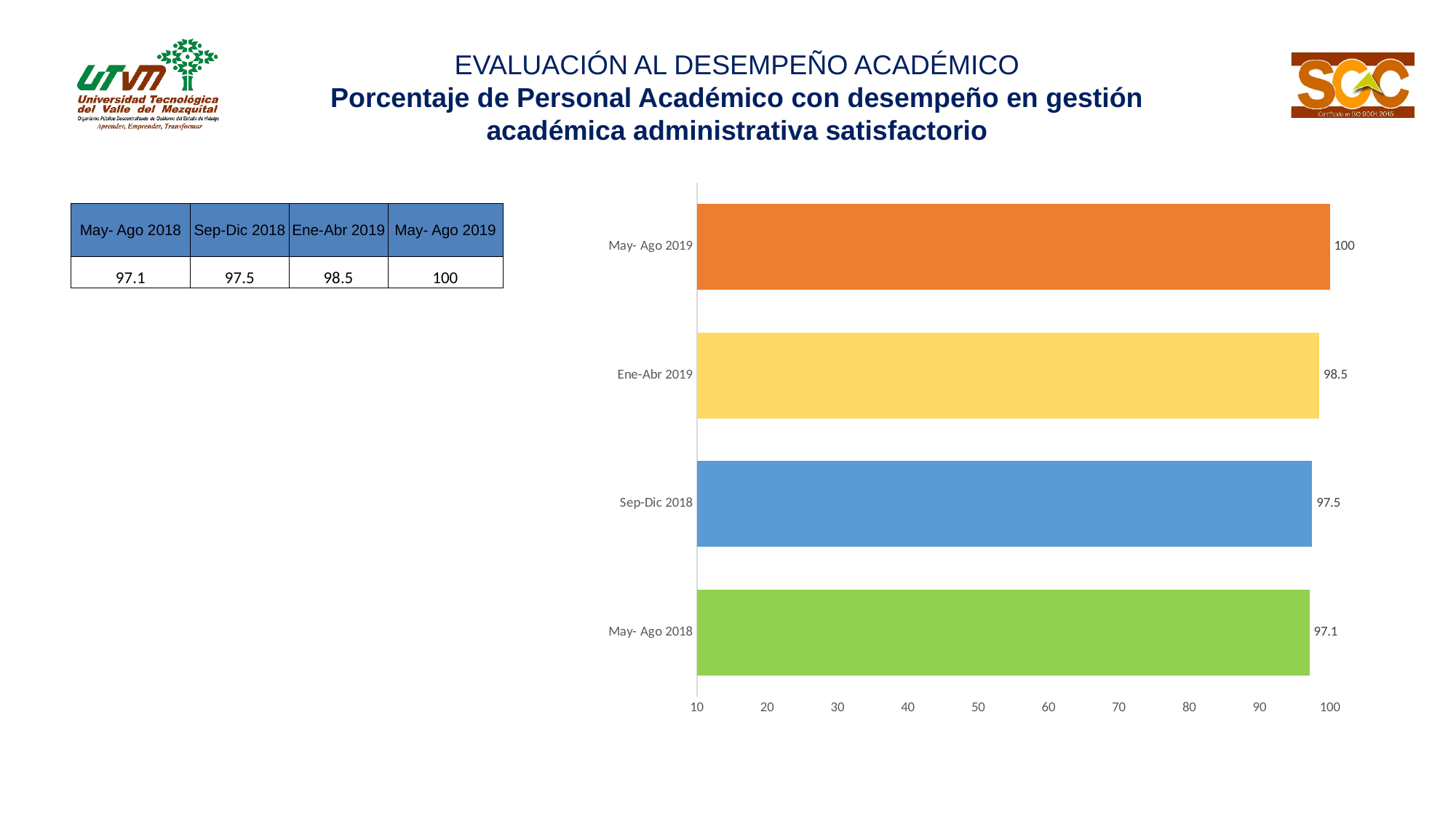
What is the value for May- Ago 2018? 97.1 What is the difference between the values for Ene-Abr 2019 and Sep-Dic 2018? 1 Which is larger, the value for Ene-Abr 2019 or the value for Sep-Dic 2018? Ene-Abr 2019 What is the value for May- Ago 2019? 100 Which period has the highest value? May- Ago 2019 Which period has the lowest value? May- Ago 2018 What colour is the bar for May- Ago 2019? Orange What is the difference between the values for May- Ago 2019 and May- Ago 2018? 2.9 What is the value for Ene-Abr 2019? 98.5 How many periods are shown in the chart? 4 What kind of chart is shown on the slide? Bar chart What is the value for Sep-Dic 2018? 97.5